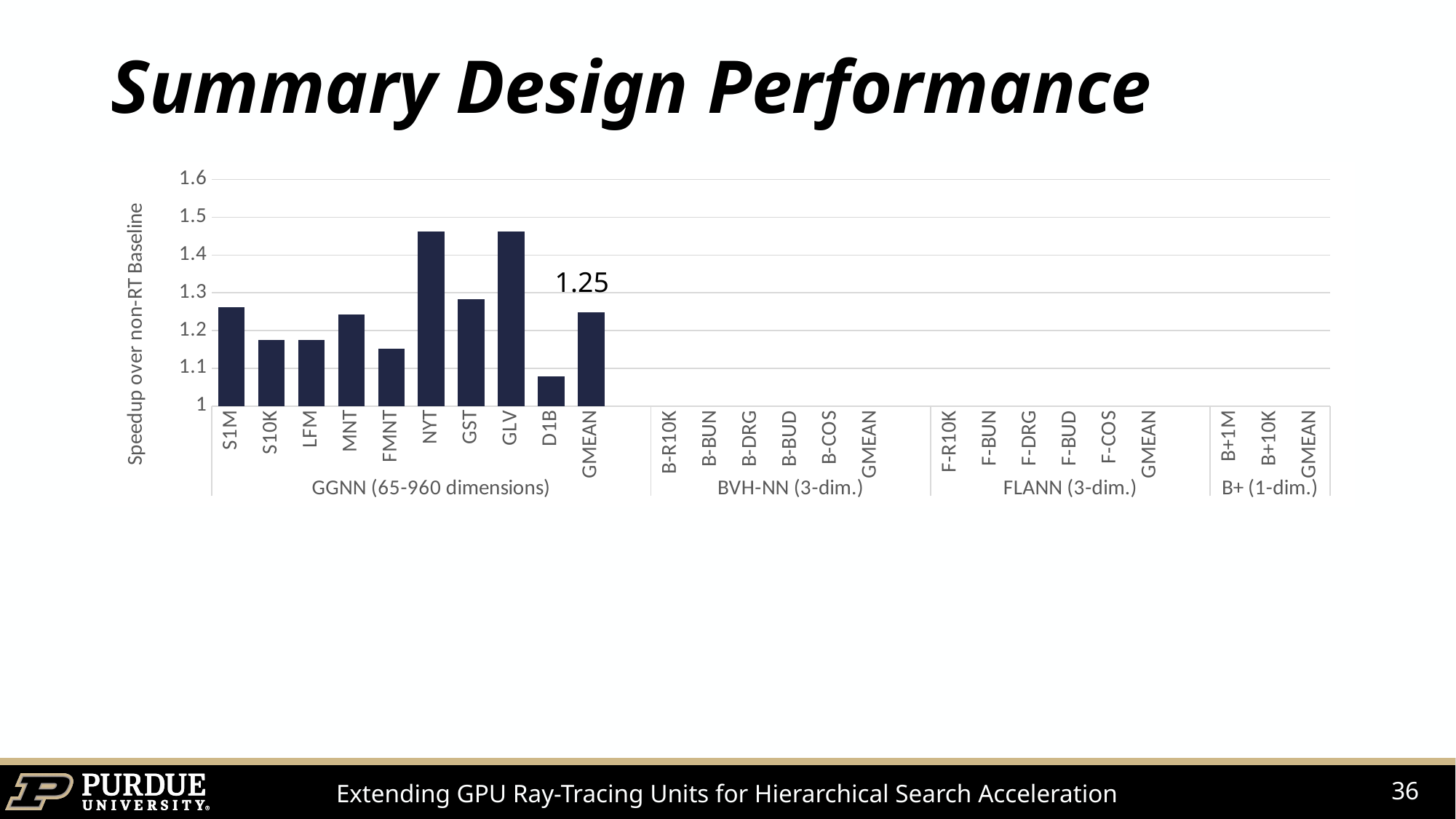
Is the value for FMNT greater or less than 1.2? less What kind of chart is shown on the slide? bar chart Which has the larger speedup, NYT or GST? NYT Which has the larger speedup, S1M or D1B? S1M What is the value of the GMEAN bar in the GGNN (65-960 dimensions) group? 1.25 Which category in the GGNN (65-960 dimensions) group has the lowest speedup? D1B Is the value for S1M greater or less than 1.2? greater Is the value for NYT greater or less than 1.4? greater What is the label of the y axis? Speedup over non-RT Baseline How many benchmark groups are labelled along the x axis? 4 How many bars are plotted in the GGNN (65-960 dimensions) group? 10